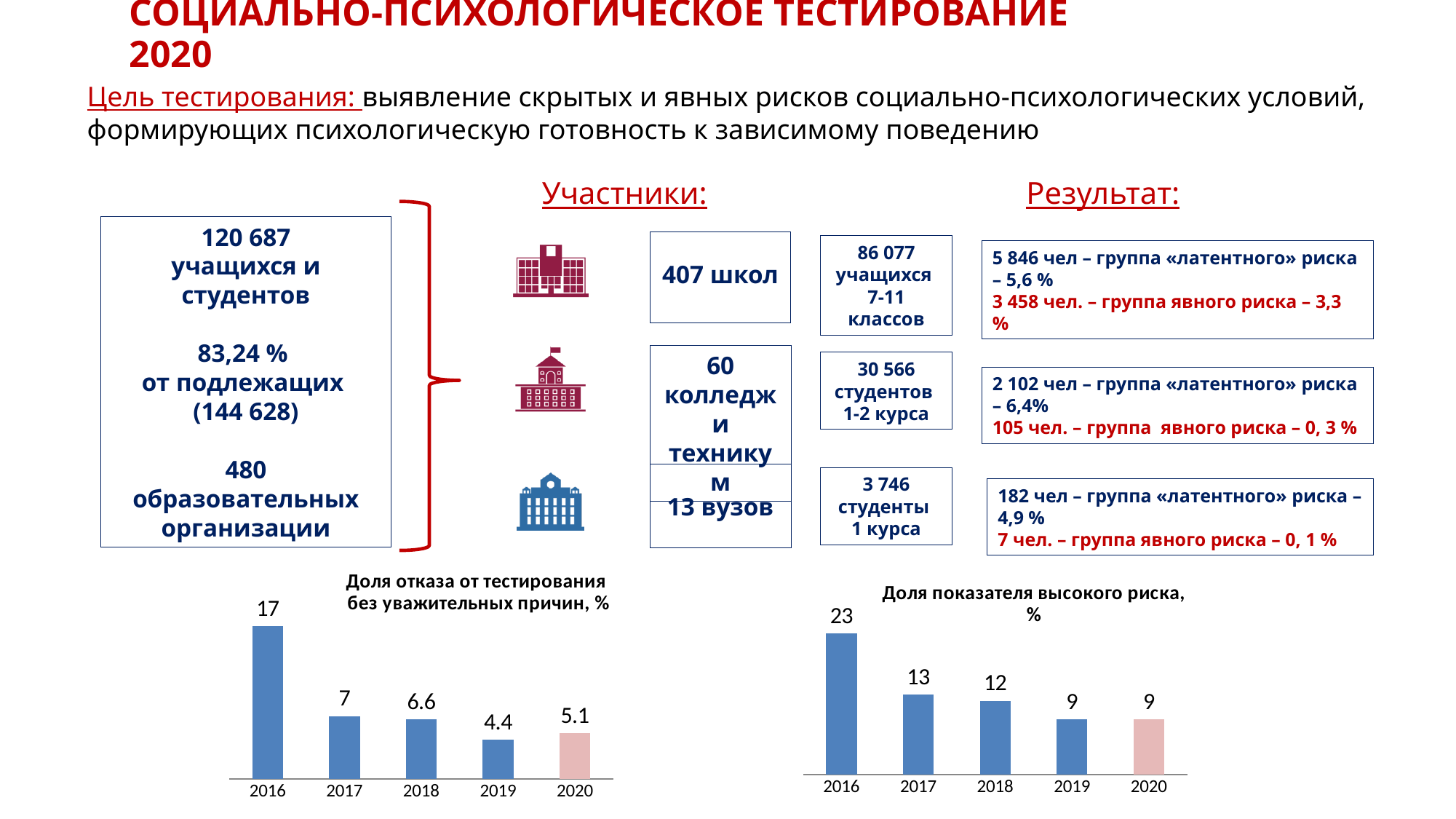
In the left chart 'Доля отказа от тестирования без уважительных причин, %', what is the difference between the values for 2016 and 2017? 10 In the right chart 'Доля показателя высокого риска, %', do the values generally rise or fall from 2016 to 2019? Fall What type of chart is the right chart 'Доля показателя высокого риска, %'? Bar chart In the left chart 'Доля отказа от тестирования без уважительных причин, %', what is the value for 2016? 17 How many years are shown on the x axis of the left chart 'Доля отказа от тестирования без уважительных причин, %'? 5 In the right chart 'Доля показателя высокого риска, %', which year has the highest value? 2016 In the right chart 'Доля показателя высокого риска, %', what is the difference between the values for 2017 and 2019? 4 In the left chart 'Доля отказа от тестирования без уважительных причин, %', which is larger, the value for 2018 or the value for 2020? 2018 In the left chart 'Доля отказа от тестирования без уважительных причин, %', what is the value for 2020? 5.1 In the right chart 'Доля показателя высокого риска, %', what is the value for 2018? 12 In the left chart 'Доля отказа от тестирования без уважительных причин, %', which year has the lowest value? 2019 In the right chart 'Доля показателя высокого риска, %', what is the value for 2016? 23